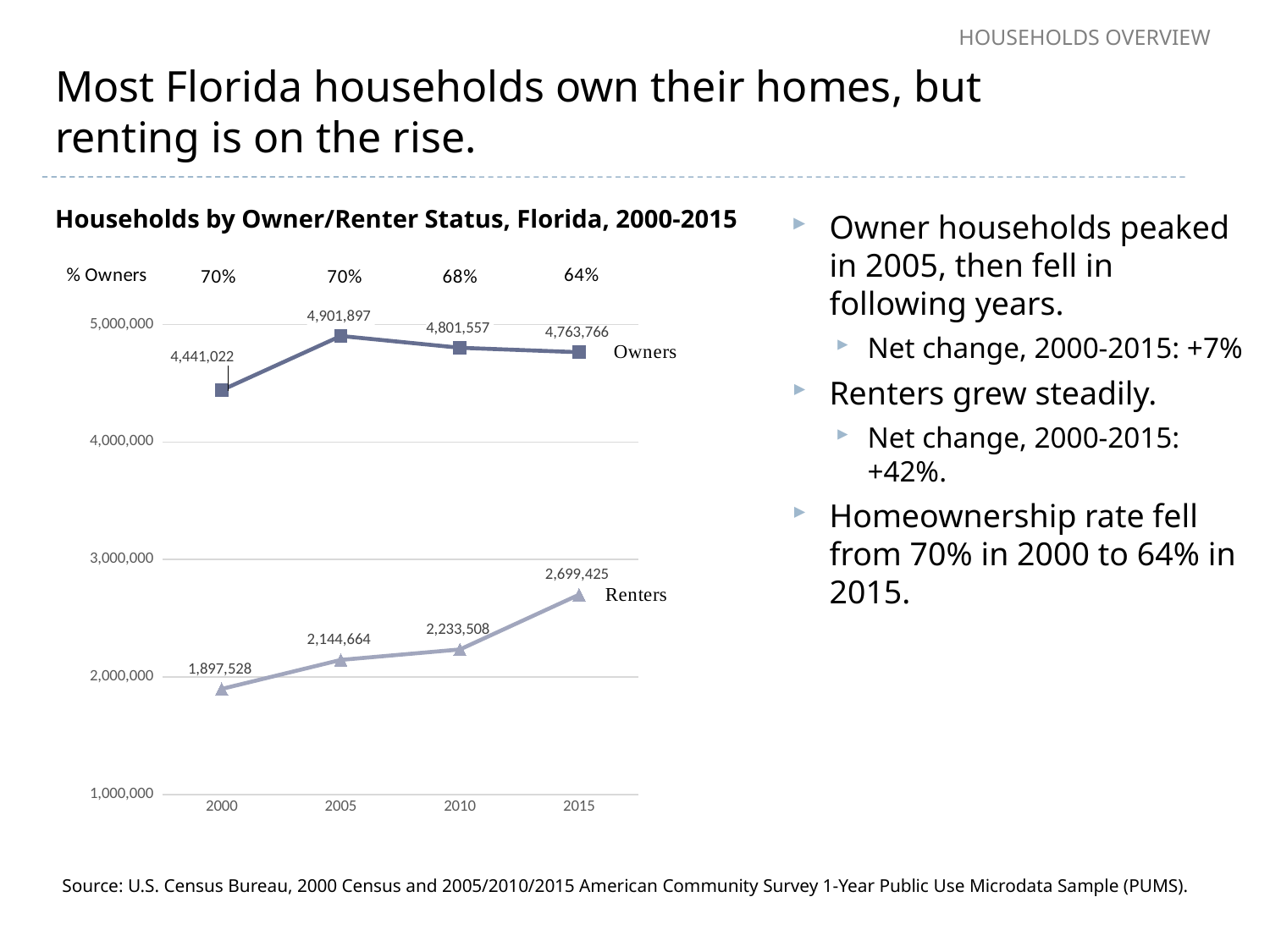
Which is larger in 2015: the number of owner households or the number of renter households? owner households In which year was the Renters series at its lowest value? 2000 What is the difference between owner households in 2005 and in 2000? 460,875 What is the number of owner households in 2010? 4,801,557 What is the number of owner households in Florida in 2000? 4,441,022 How many years (data points per series) are plotted on the x axis? 4 In which year did the Owners series reach its highest value? 2005 How many series are plotted in the chart? 2 What is the title of the chart? Households by Owner/Renter Status, Florida, 2000-2015 What type of chart is shown on the slide? line chart By how much did renter households increase from 2000 to 2015? 801,897 What is the number of renter households in Florida in 2015? 2,699,425